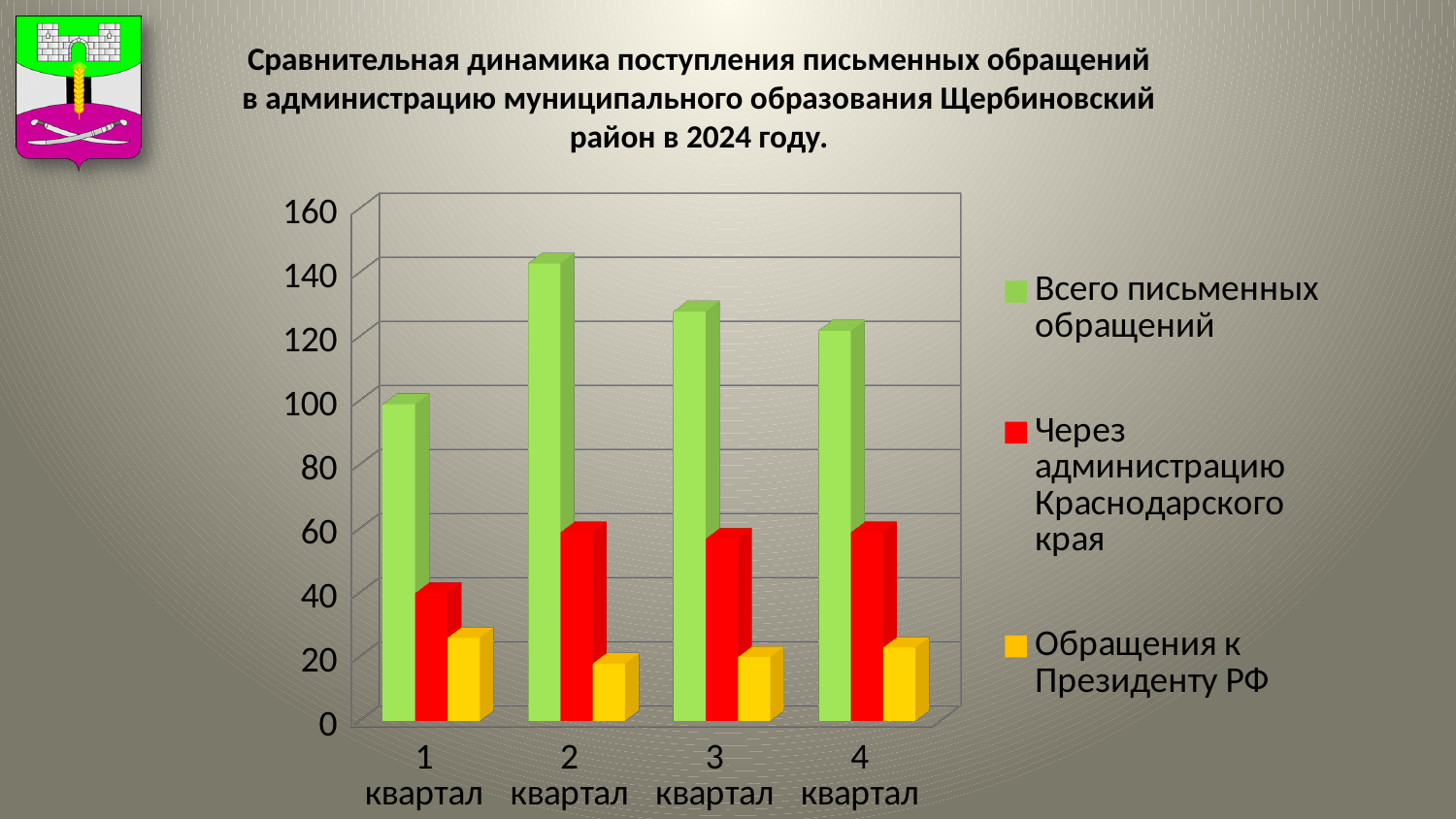
Which is larger: "Всего письменных обращений" in 1 квартал or in 4 квартал? 4 квартал In which quarter is the value for "Через администрацию Краснодарского края" the lowest? 1 квартал How many quarters (categories) are shown on the x axis? 4 Which colour represents "Обращения к Президенту РФ" in the chart? yellow Is the value for "Всего письменных обращений" in 1 квартал greater or less than 120? less How many series does the legend list? 3 What kind of chart is shown on the slide? bar chart In which quarter is the value for "Всего письменных обращений" the lowest? 1 квартал Is the value for "Через администрацию Краснодарского края" in 4 квартал greater or less than 40? greater Is the value for "Всего письменных обращений" in 2 квартал greater or less than 120? greater In which quarter is the value for "Всего письменных обращений" the highest? 2 квартал